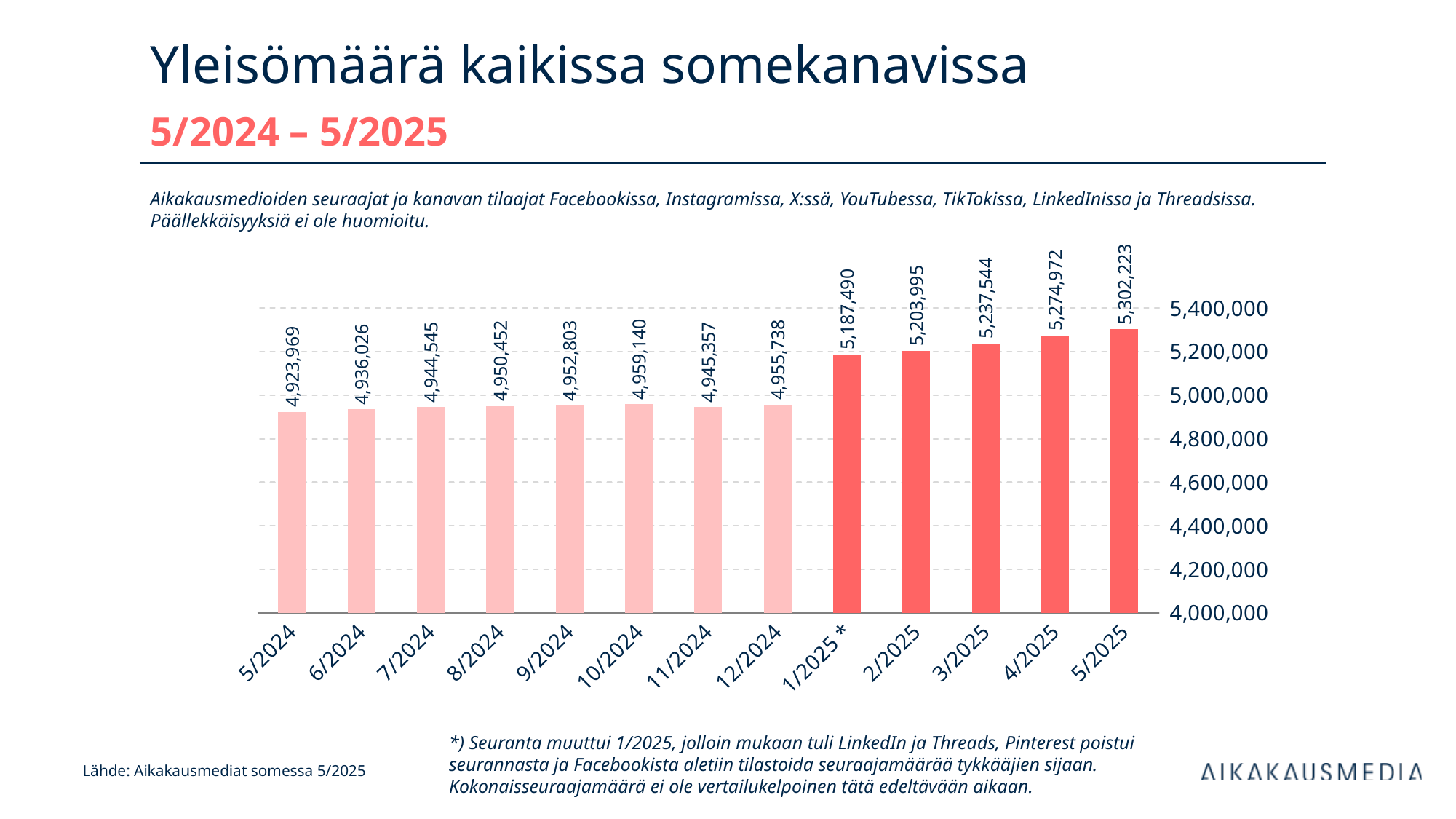
Which is larger, the value for 11/2024 or the value for 12/2024? 12/2024 Is the value for 8/2024 greater or less than 5,000,000? less How many months are shown on the x axis? 13 Which month has the highest value? 5/2025 What is the difference between the values for 5/2025 and 5/2024? 378,254 Which month has the lowest value? 5/2024 What is the value for 1/2025 *? 5,187,490 What kind of chart is shown on the slide? bar chart What is the difference between the values for 1/2025 * and 12/2024? 231,752 What is the value for 10/2024? 4,959,140 What is the value for 5/2024? 4,923,969 Do the values rise or fall from 1/2025 * to 5/2025? rise